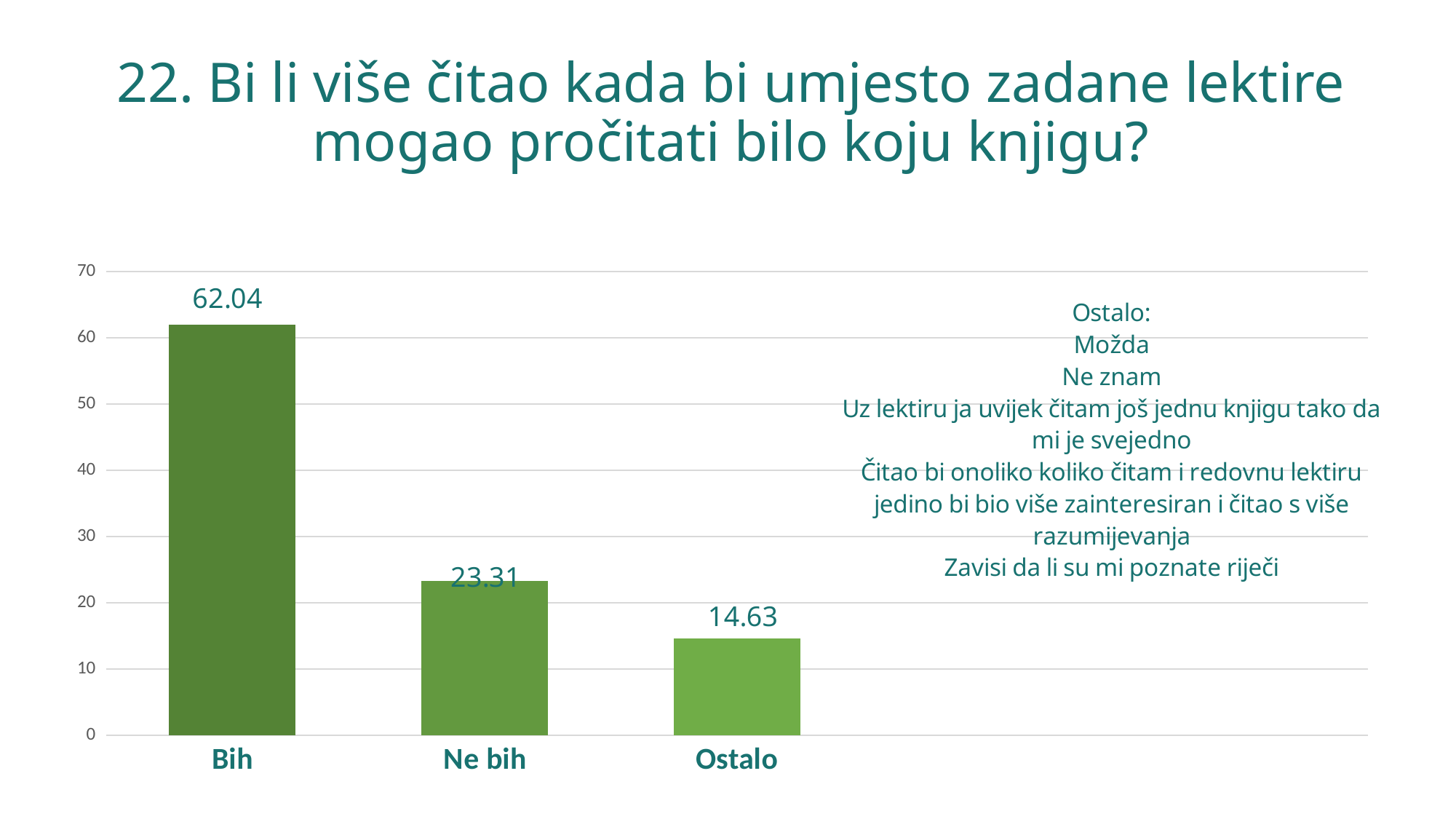
What is the value for Ostalo? 14.63 Do the values rise or fall from left to right along the x axis? fall How many categories are shown on the chart? 3 Is the value for Bih greater or less than 60? greater What kind of chart is shown on the slide? bar chart Which is larger, the value for Ne bih or the value for Ostalo? Ne bih What is the difference between the values for Ne bih and Ostalo? 8.68 What is the difference between the values for Bih and Ne bih? 38.73 Which category has the lowest value? Ostalo Which category has the highest value? Bih What is the value for Ne bih? 23.31 What is the value for Bih? 62.04